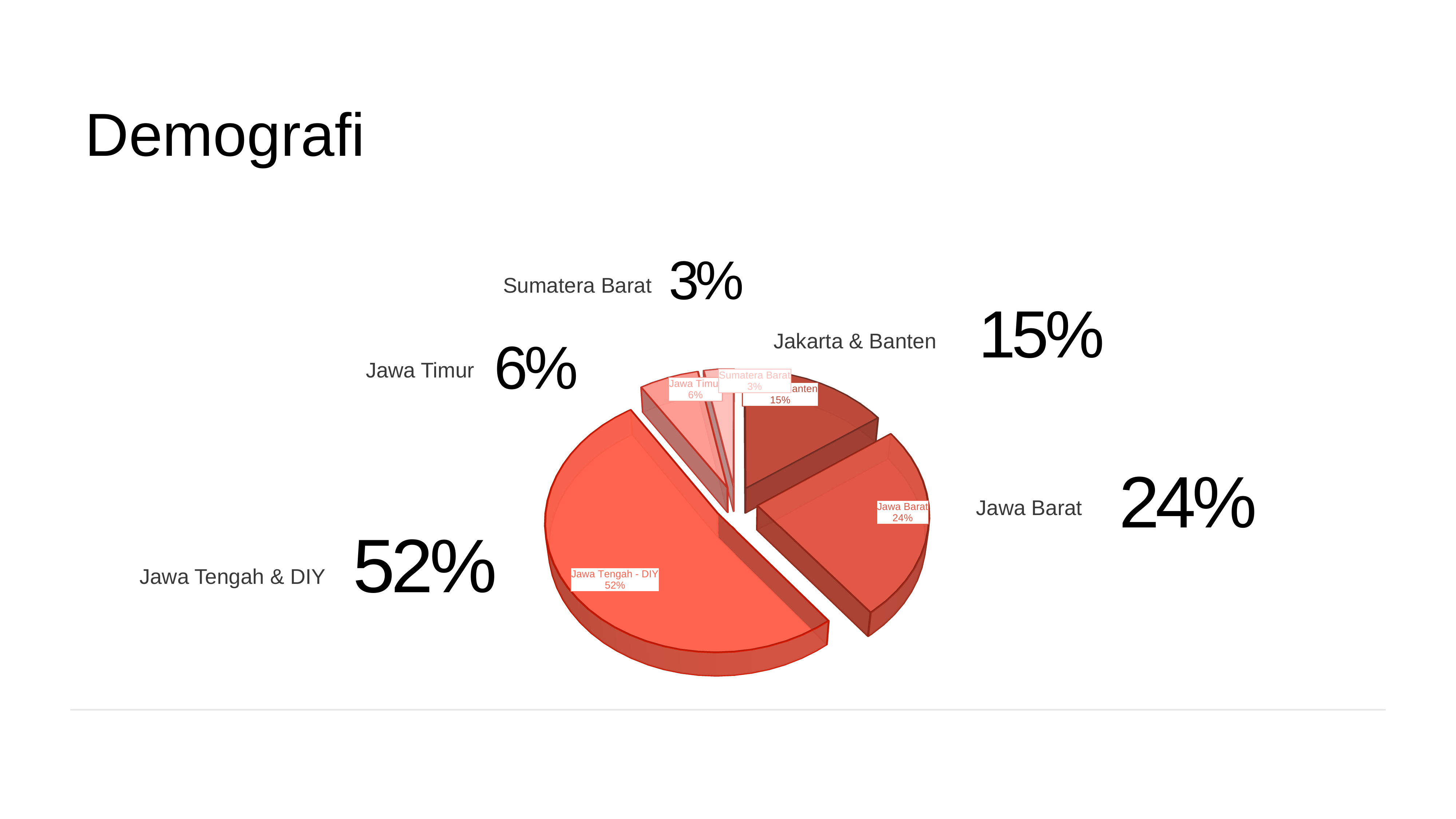
What is the value shown for Sumatera Barat? 3% What is the value shown for Jawa Barat? 24% What is the value shown for Jakarta & Banten? 15% What is the title of the slide containing the chart? Demografi Which region has the largest slice of the pie? Jawa Tengah & DIY What share of the pie does Jawa Tengah & DIY hold? 52% How many regions are shown in the pie chart? 5 What is the difference between the shares of Jawa Barat and Jakarta & Banten? 9% What is the value shown for Jawa Timur? 6% Which region has the smallest slice of the pie? Sumatera Barat What kind of chart is shown on the slide? Pie chart Which is larger, the share for Jawa Timur or the share for Sumatera Barat? Jawa Timur